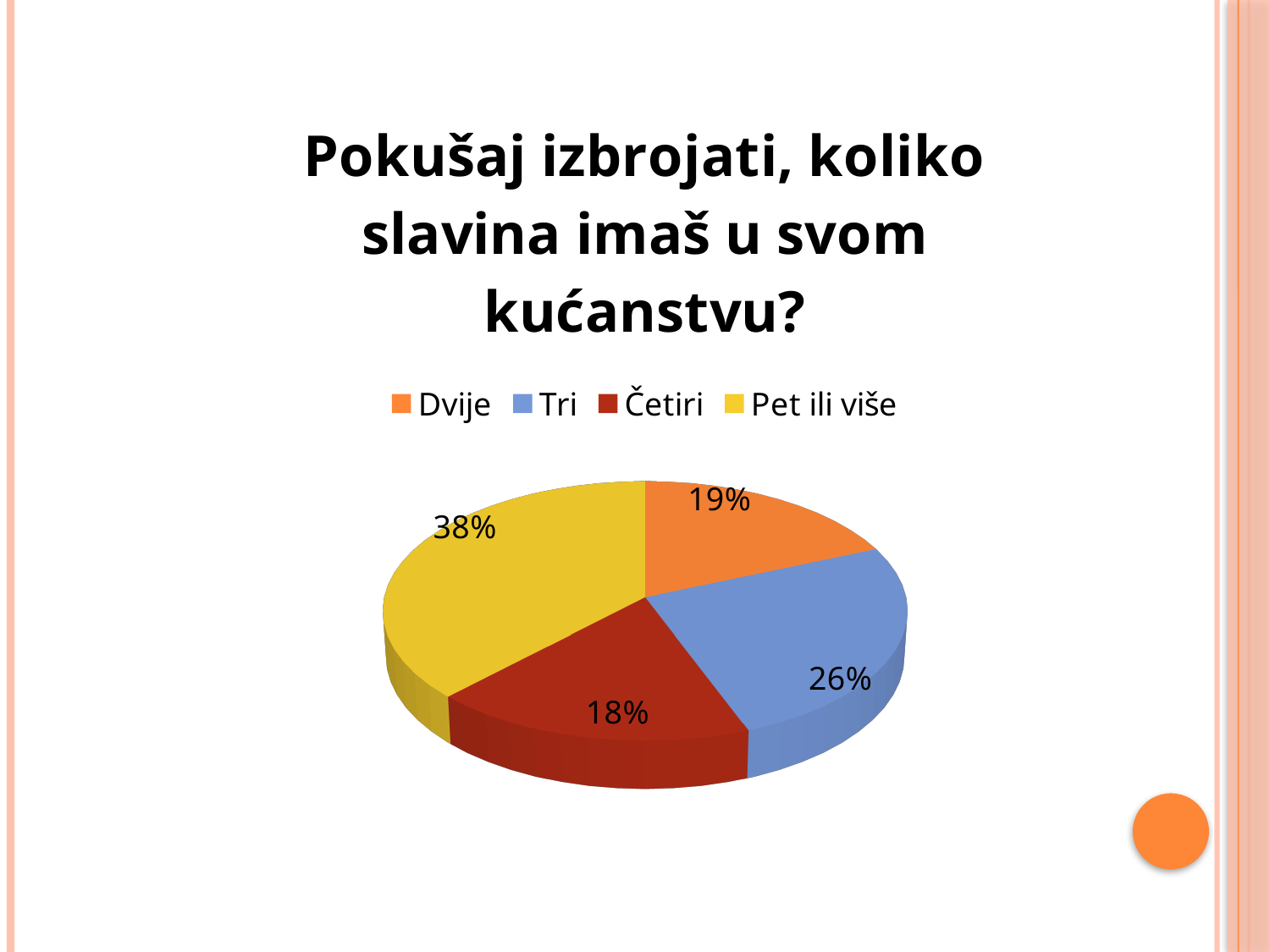
What kind of chart is shown on the slide? Pie chart Which category has the largest slice of the pie? Pet ili više What is the title of the chart? Pokušaj izbrojati, koliko slavina imaš u svom kućanstvu? What is the value shown for 'Dvije'? 19% Which colour represents 'Četiri' in the legend? Red Which is larger, the value for 'Tri' or the value for 'Dvije'? Tri Which category has the smallest slice of the pie? Četiri What is the difference between the 'Pet ili više' and 'Tri' values? 12% How many categories does the pie chart show? 4 What share of the pie does the 'Pet ili više' slice represent? 38% What is the value shown for 'Četiri'? 18% What is the value shown for 'Tri'? 26%